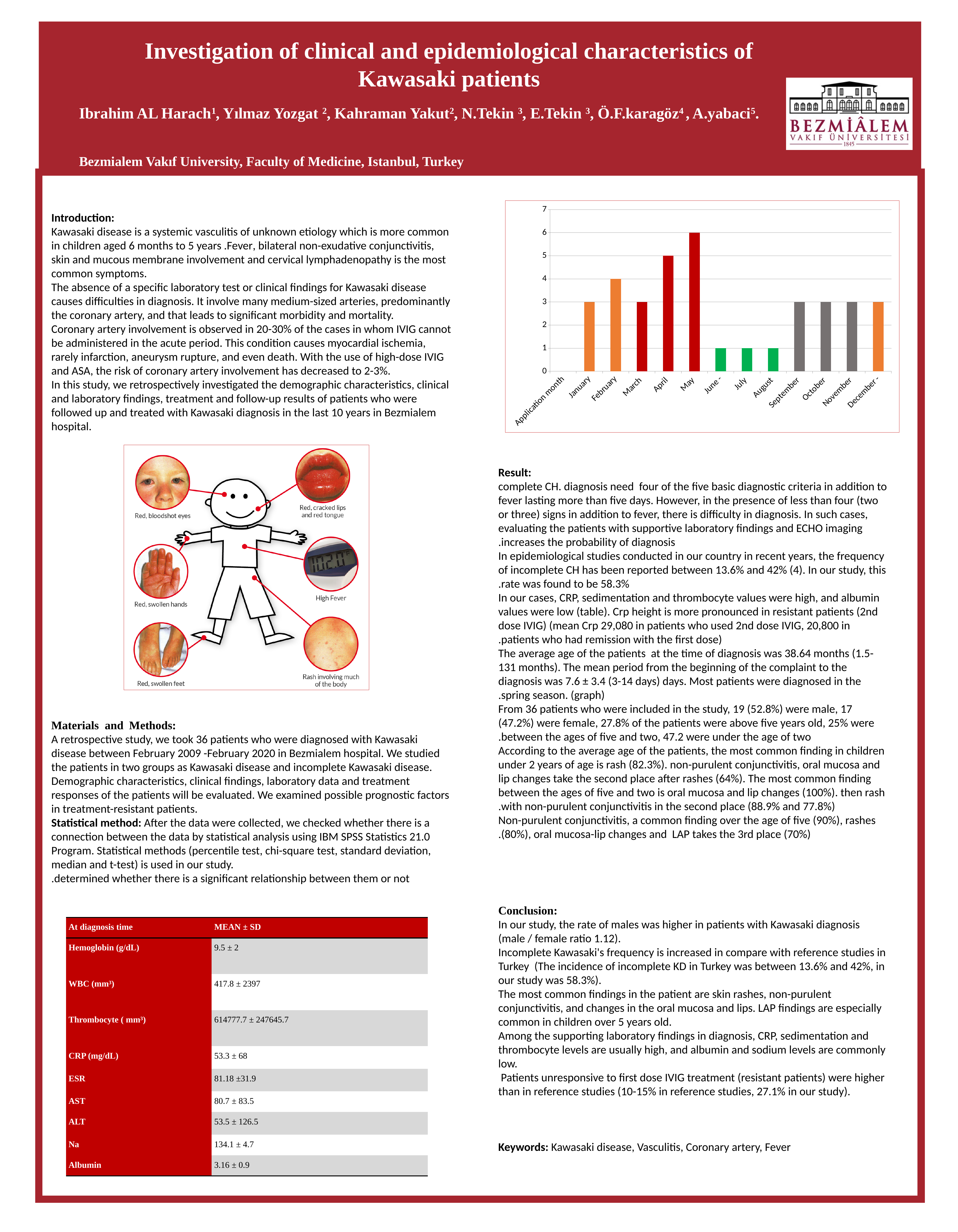
What is the difference between the values for May and April? 1 What is the value for February in the chart? 4 What is the value for May in the chart? 6 Do the values rise or fall from June to August? They stay the same What is the value for April in the chart? 5 What is the value for July in the chart? 1 Which month has the highest bar in the chart? May Is the value for May greater or less than 5? greater How many bars are plotted in the chart? 12 What is the highest value shown on the vertical axis of the chart? 7 Which is larger, the value for February or the value for March? February What kind of chart is shown on the slide? bar chart